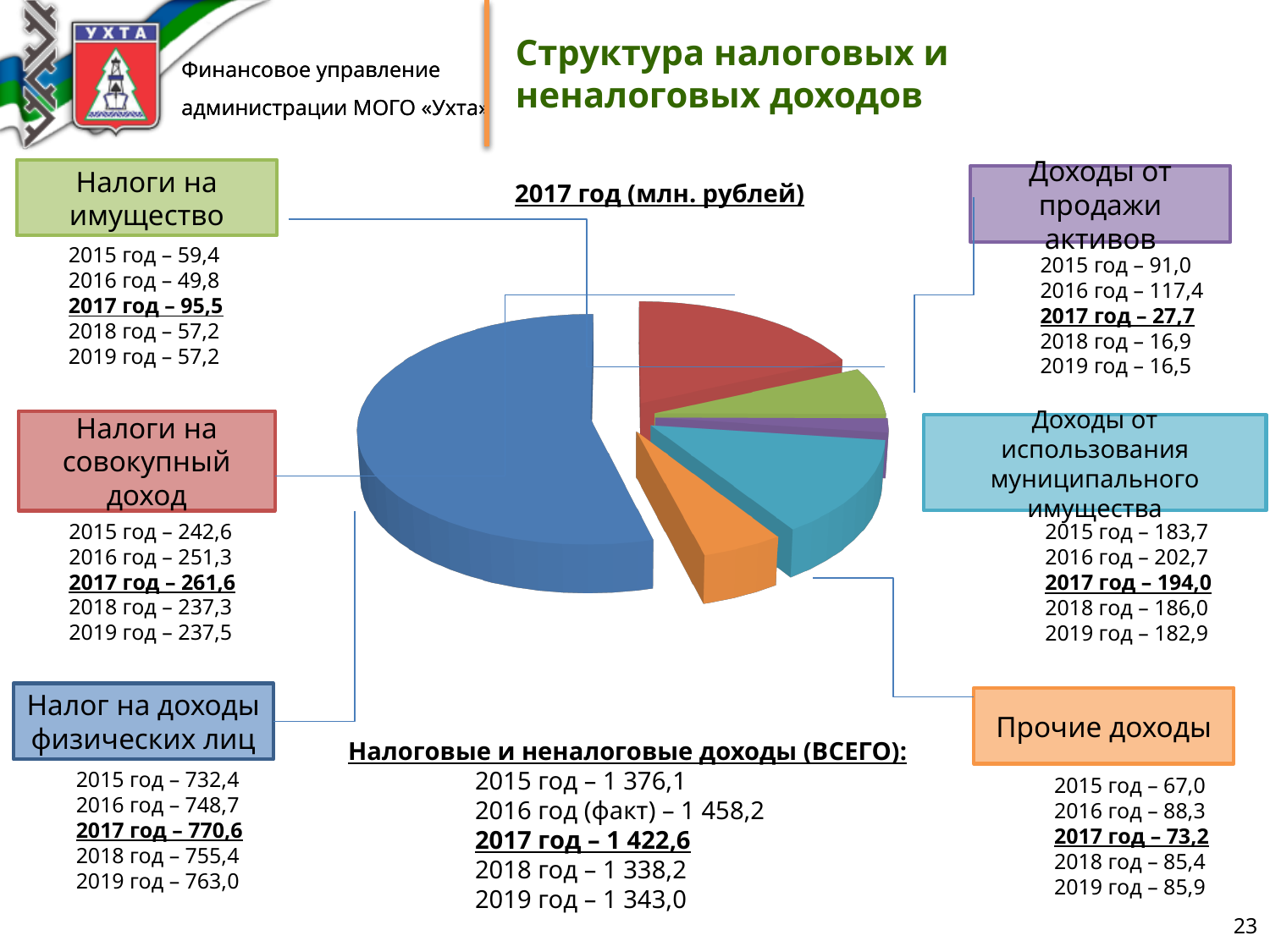
Which is larger in 2017: Налоги на имущество or Прочие доходы? Налоги на имущество What is the difference between the 2017 values for Налог на доходы физических лиц and Налоги на совокупный доход? 509,0 What is the 2017 value for Налоги на совокупный доход? 261,6 Which category has the smallest slice in the pie chart? Доходы от продажи активов How many slices does the pie chart have? 6 What is the 2017 value for Доходы от продажи активов? 27,7 What is the 2017 value for Налог на доходы физических лиц? 770,6 What is the title of the pie chart? 2017 год (млн. рублей) Which category has the largest slice in the pie chart? Налог на доходы физических лиц What kind of chart is shown on the slide? pie chart What is the 2017 value for Доходы от использования муниципального имущества? 194,0 What colour is the largest slice of the pie chart? blue